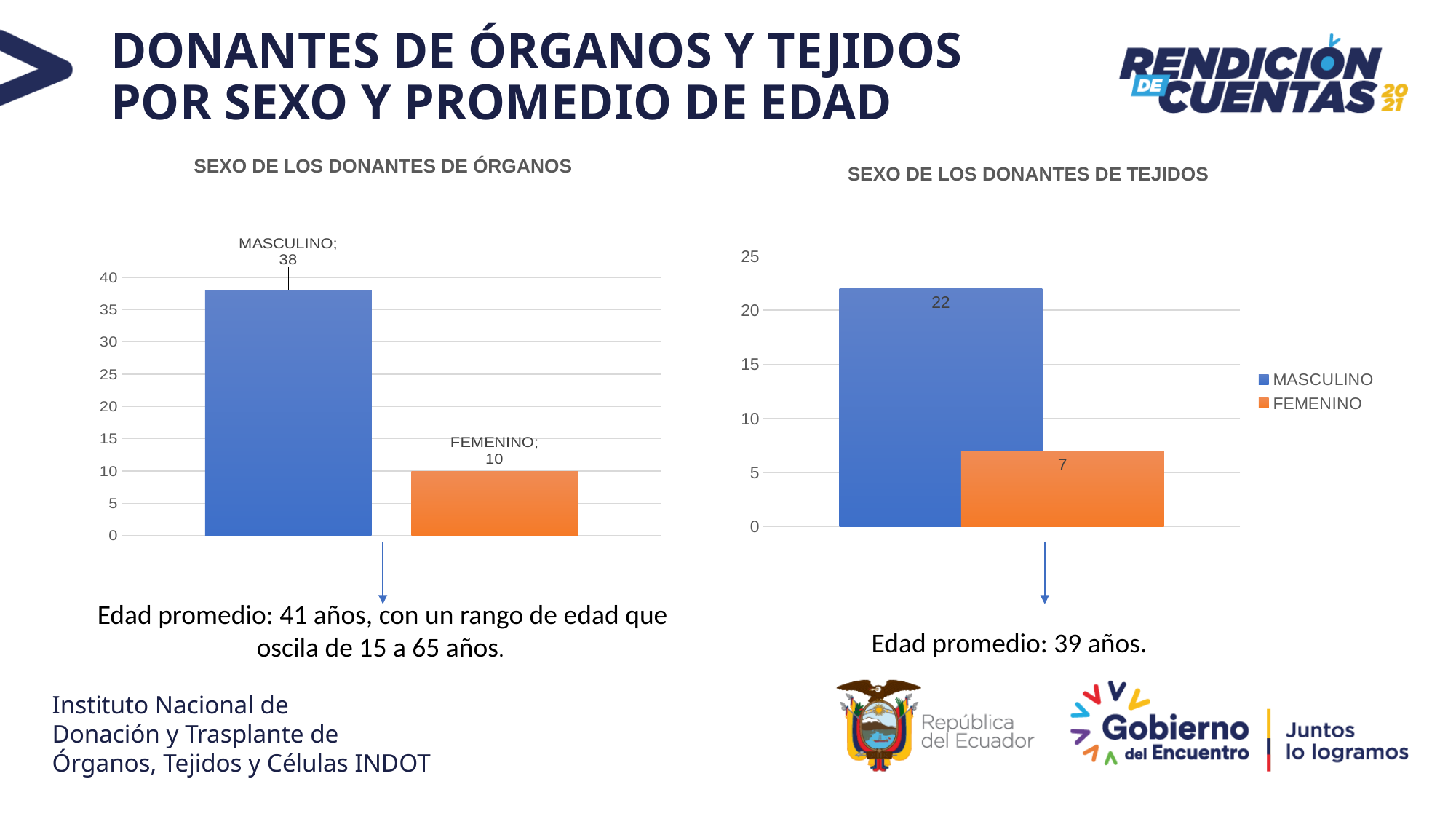
In the chart titled 'SEXO DE LOS DONANTES DE ÓRGANOS', which category has the highest value? MASCULINO In the chart titled 'SEXO DE LOS DONANTES DE TEJIDOS', what is the value for FEMENINO? 7 In the chart titled 'SEXO DE LOS DONANTES DE TEJIDOS', what colour is the FEMENINO bar? Orange In the chart titled 'SEXO DE LOS DONANTES DE ÓRGANOS', what is the difference between the MASCULINO and FEMENINO values? 28 In the chart titled 'SEXO DE LOS DONANTES DE TEJIDOS', is the value for MASCULINO greater or less than 20? greater In the chart titled 'SEXO DE LOS DONANTES DE TEJIDOS', what is the difference between the MASCULINO and FEMENINO values? 15 In the chart titled 'SEXO DE LOS DONANTES DE TEJIDOS', what is the value for MASCULINO? 22 In the chart titled 'SEXO DE LOS DONANTES DE ÓRGANOS', what is the value for MASCULINO? 38 How many series does the legend list in the chart titled 'SEXO DE LOS DONANTES DE TEJIDOS'? 2 In the chart titled 'SEXO DE LOS DONANTES DE TEJIDOS', which category has the lowest value? FEMENINO In the chart titled 'SEXO DE LOS DONANTES DE ÓRGANOS', what is the value for FEMENINO? 10 What kind of chart is the chart titled 'SEXO DE LOS DONANTES DE ÓRGANOS'? Bar chart